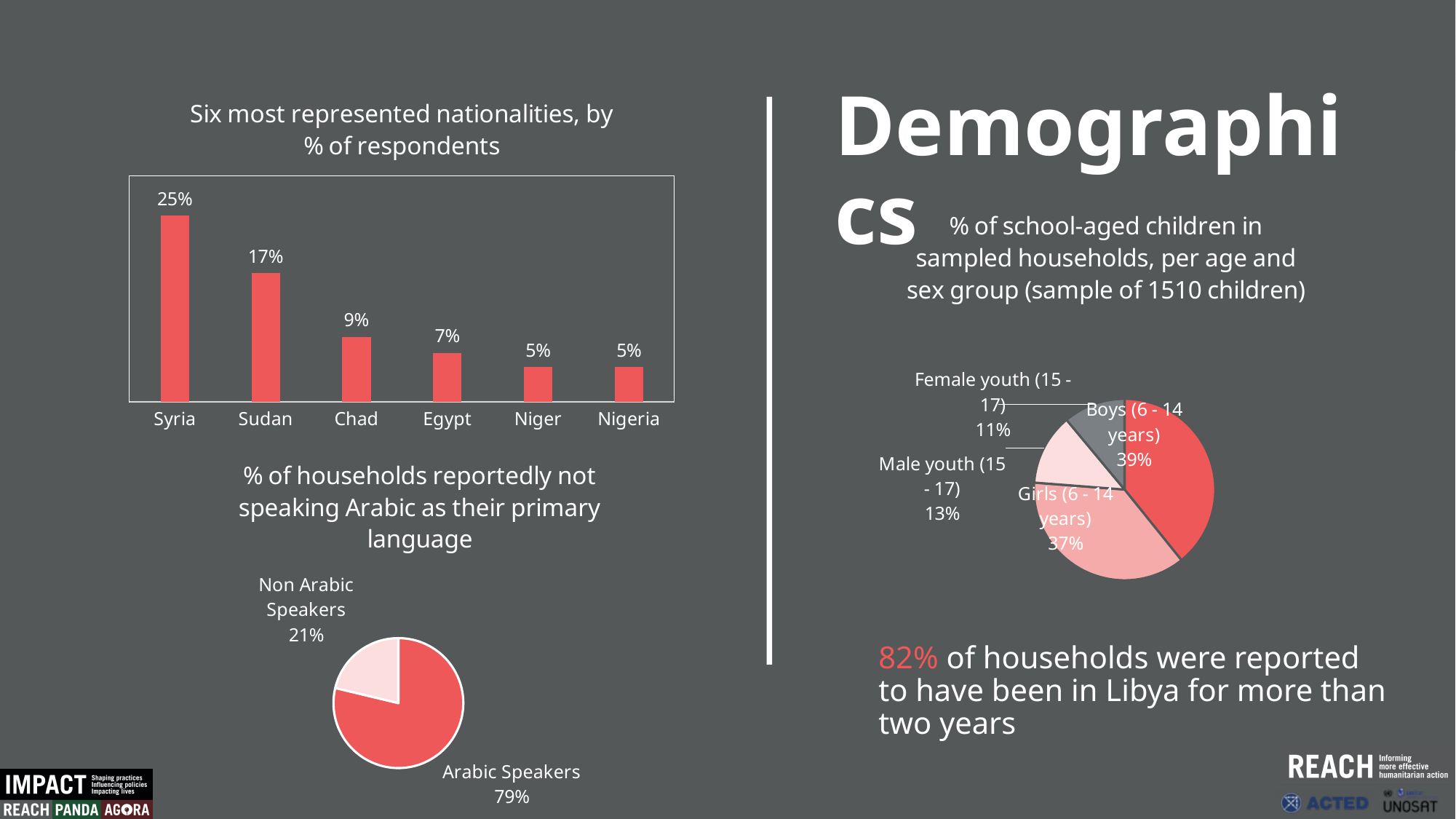
In the 'Six most represented nationalities' bar chart, how many nationalities are shown? 6 In the pie chart of school-aged children per age and sex group, how many groups are shown? 4 In the pie chart on households not speaking Arabic as their primary language, what is the value for Arabic Speakers? 79% In the 'Six most represented nationalities' bar chart, what is the difference between the values for Sudan and Chad? 8% What kind of chart is the 'Six most represented nationalities' chart? Bar chart In the 'Six most represented nationalities' bar chart, which nationality has the highest percentage of respondents? Syria In the pie chart of school-aged children per age and sex group, what share is Boys (6 - 14 years)? 39% In the pie chart on households not speaking Arabic as their primary language, what share is Non Arabic Speakers? 21% In the 'Six most represented nationalities' bar chart, do the values rise or fall from Syria to Nigeria? Fall In the pie chart of school-aged children per age and sex group, which group has the smallest share? Female youth (15 - 17) In the 'Six most represented nationalities' bar chart, what is the value for Syria? 25% In the 'Six most represented nationalities' bar chart, which is larger, the value for Chad or the value for Egypt? Chad